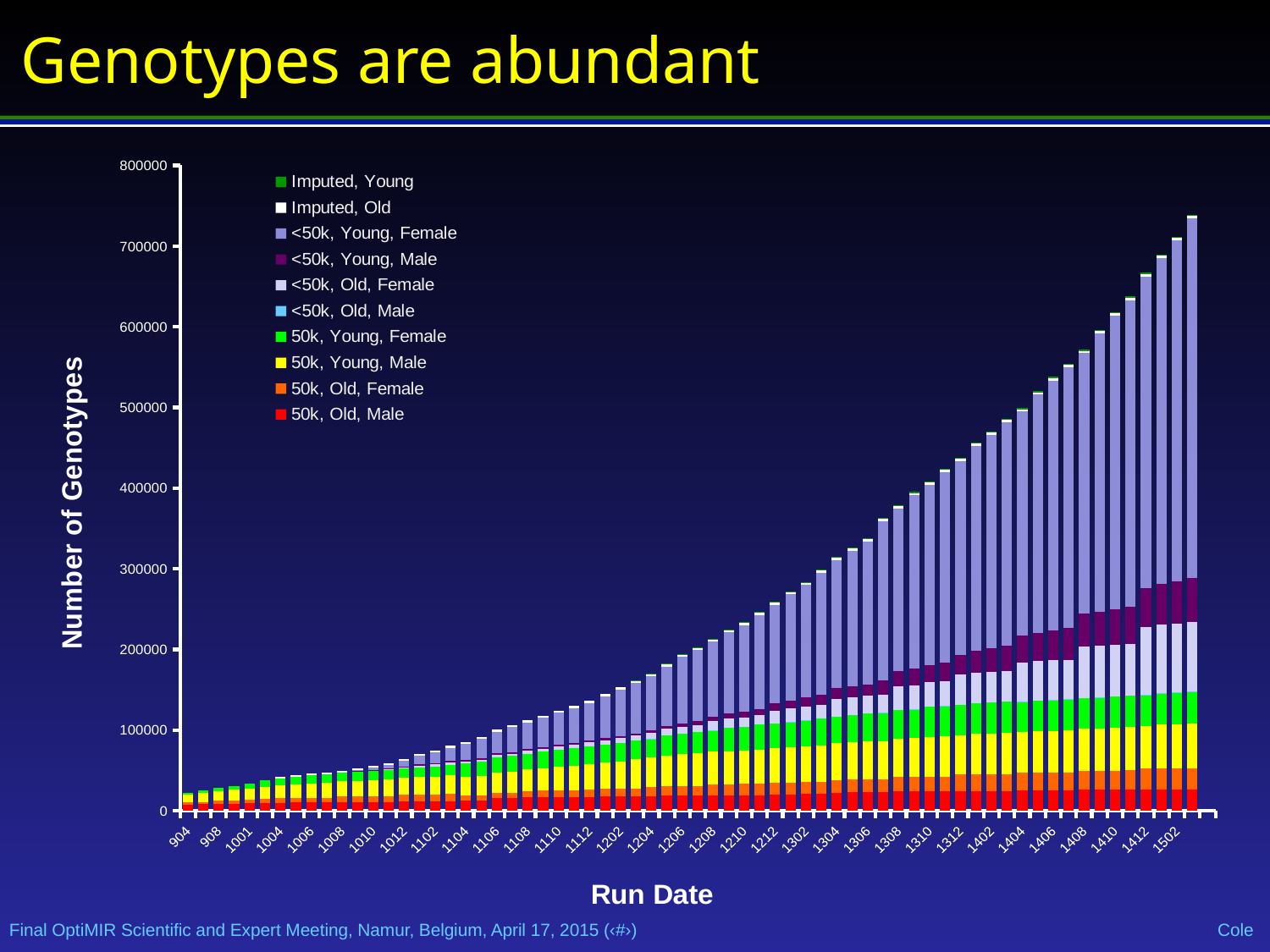
How many series does the legend list? 10 What is the highest value shown on the vertical axis? 800000 Do the total number of genotypes rise or fall as the run date moves from 904 to 1502? rise Which series is shown in red at the bottom of each stacked bar? 50k, Old, Male What is the title of the vertical axis? Number of Genotypes Which has the taller bar, run date 1004 or run date 1404? 1404 Is the total value for run date 1206 greater or less than 300000? less Is the total value for run date 904 greater or less than 100000? less What kind of chart is shown on the slide? stacked bar chart Is the total value for run date 1412 greater or less than 600000? greater